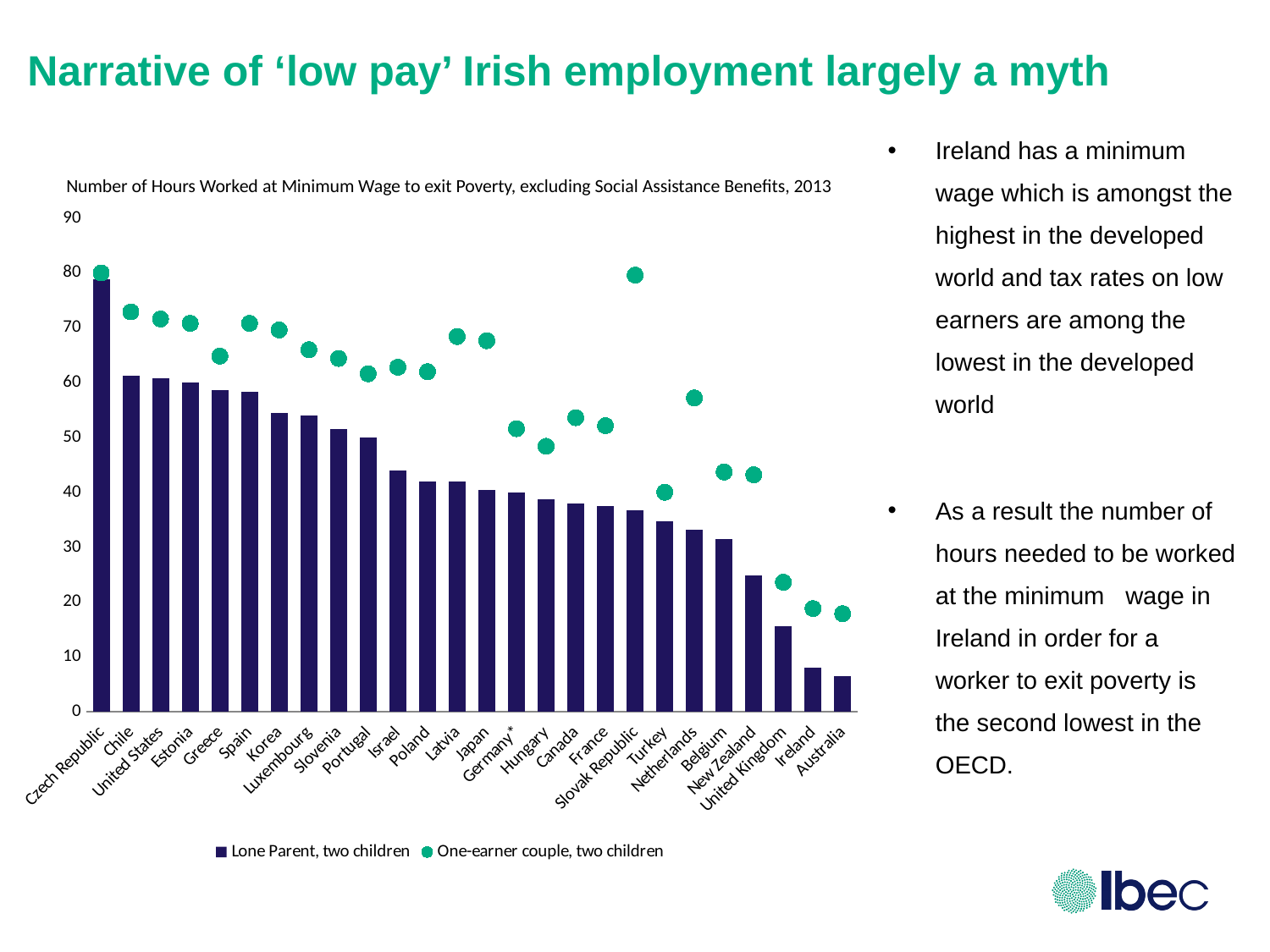
Which is larger for One-earner couple, two children: Slovak Republic or Turkey? Slovak Republic Which country has the lowest bar for Lone Parent, two children? Australia Which country has the highest bar for Lone Parent, two children? Czech Republic Is the One-earner couple, two children value for Slovak Republic greater or less than 70? greater Is the Lone Parent, two children value for Czech Republic greater or less than 70? greater Is the Lone Parent, two children value for United Kingdom greater or less than 20? less What is the title of the chart? Number of Hours Worked at Minimum Wage to exit Poverty, excluding Social Assistance Benefits, 2013 How many series does the legend list? 2 What kind of chart is shown on the slide? A combined bar and scatter (dot) chart Do the Lone Parent, two children bars generally rise or fall from left to right across the x axis? fall How many countries are shown on the x axis? 26